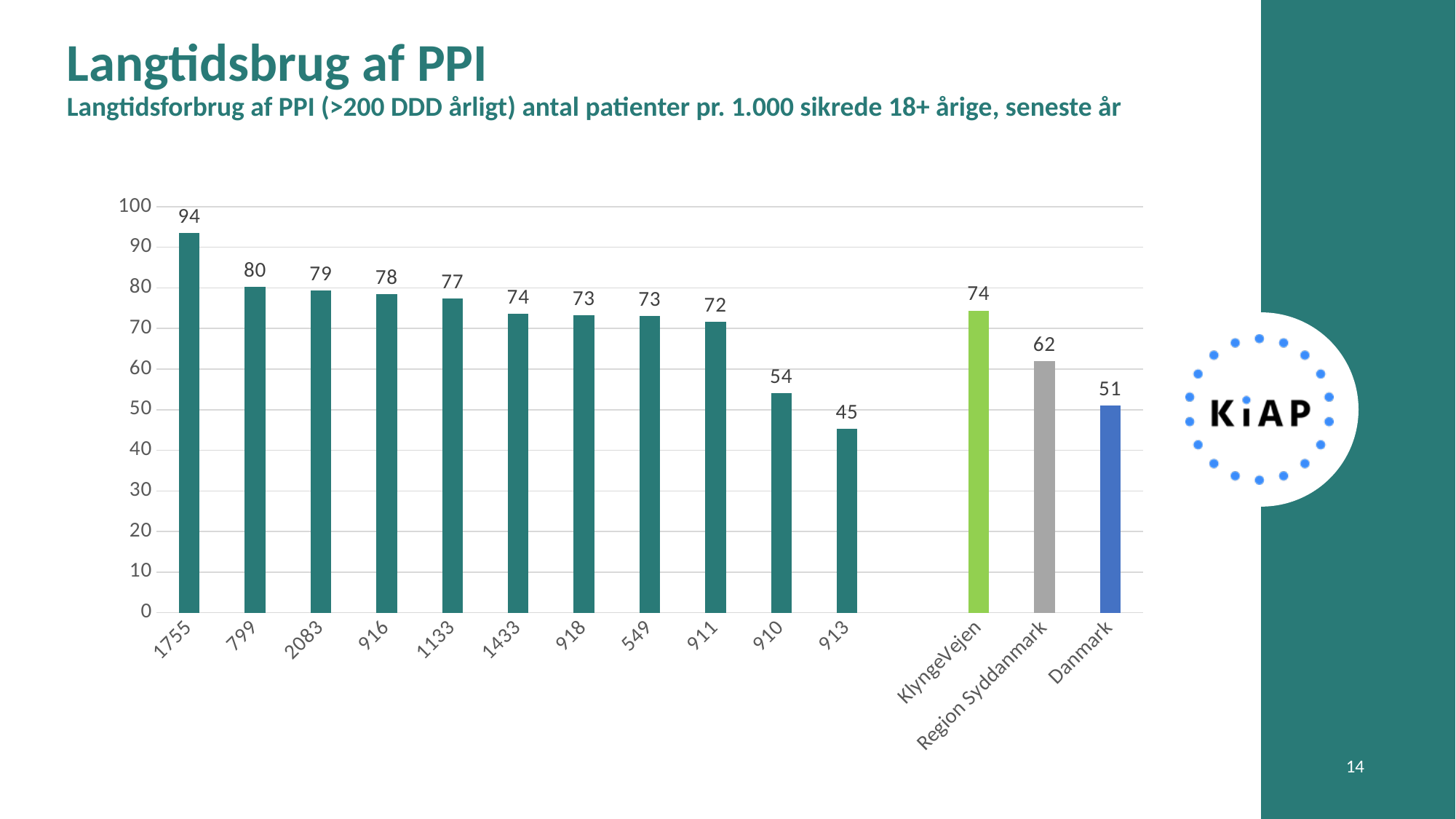
Which category has the highest value? 1755 What is the value for category 1755? 94 What kind of chart is shown on the slide? bar chart What is the value for Region Syddanmark? 62 How many bars are shown in the chart? 14 What is the difference between the values for 1755 and Danmark? 43 What is the value for Danmark? 51 Which is larger, the value for 910 or the value for Region Syddanmark? Region Syddanmark Which category has the lowest value? 913 What is the value for KlyngeVejen? 74 What colour is the bar for Danmark? blue Is the value for 913 greater or less than 50? less